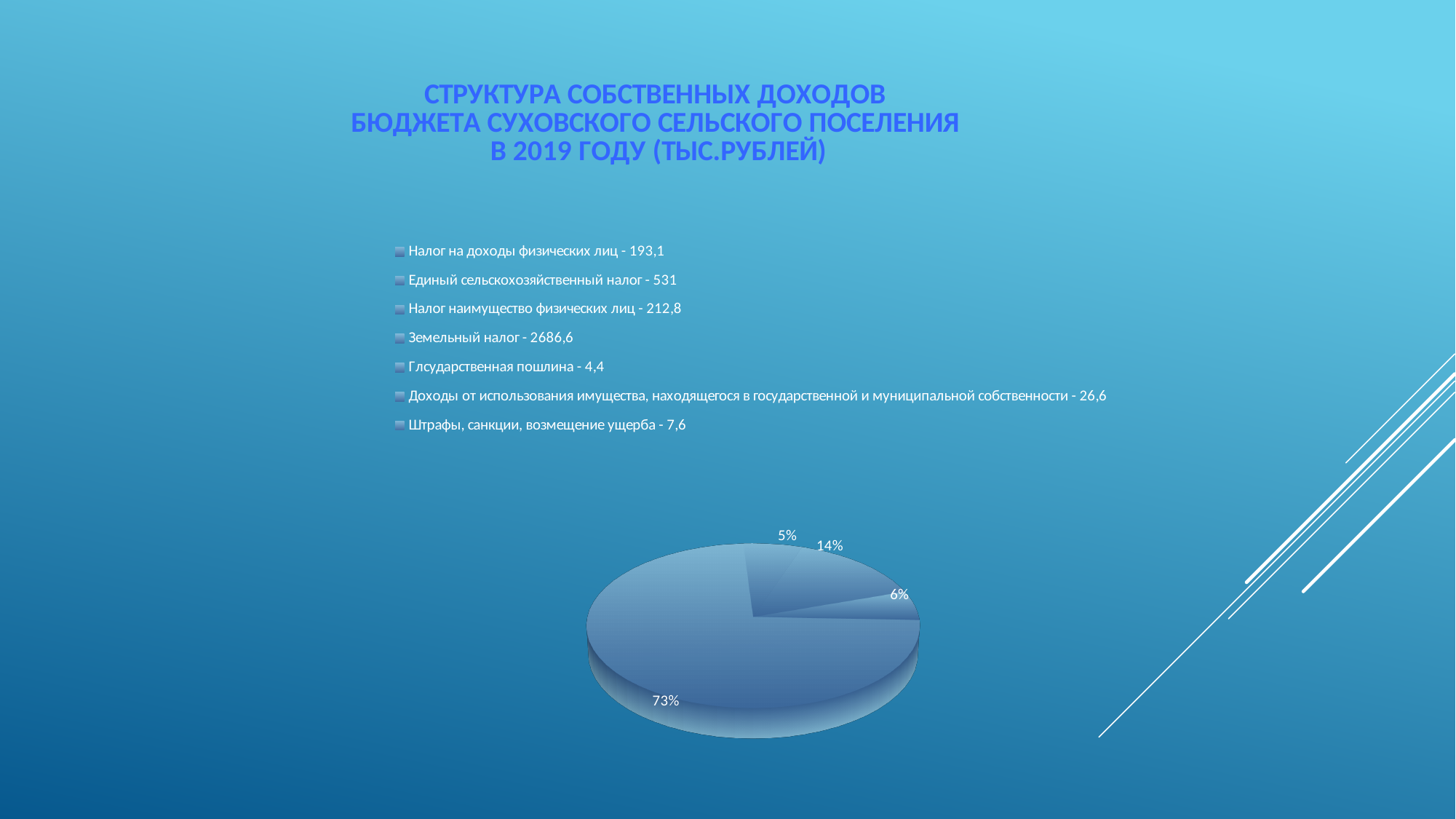
What is the value for Налог на доходы физических лиц? 193,1 Which is larger: Доходы от использования имущества, находящегося в государственной и муниципальной собственности or Штрафы, санкции, возмещение ущерба? Доходы от использования имущества, находящегося в государственной и муниципальной собственности What is the difference between the values for Единый сельскохозяйственный налог and Налог наимущество физических лиц? 318,2 Which category has the highest value? Земельный налог What kind of chart is shown on the slide? pie chart What year does the chart title refer to? 2019 What is the value for Единый сельскохозяйственный налог? 531 How many categories does the legend list? 7 Which category has the lowest value? Глсударственная пошлина What is the value for Земельный налог? 2686,6 What is the value for Штрафы, санкции, возмещение ущерба? 7,6 What share of the pie does the largest slice (Земельный налог) take? 73%